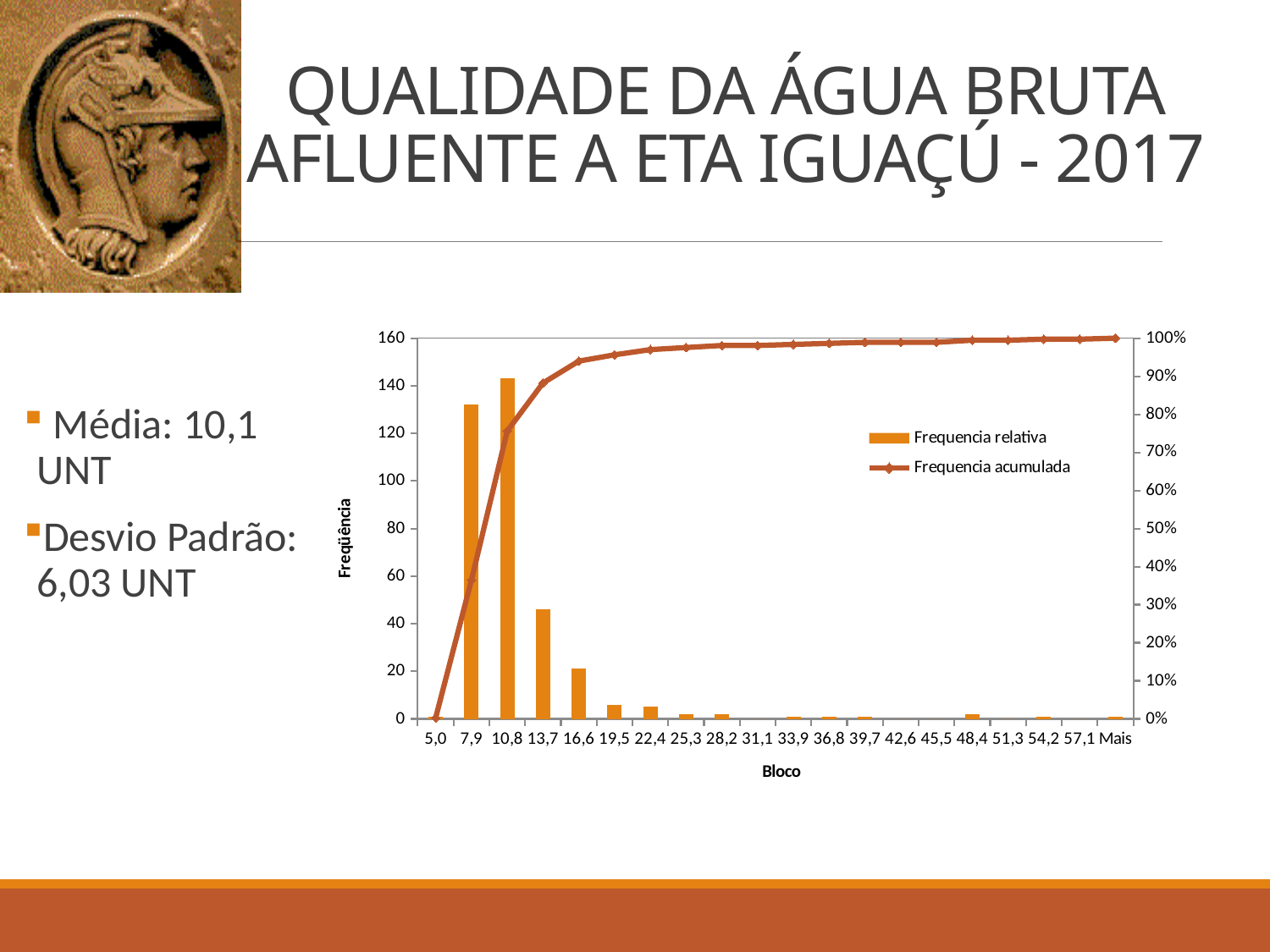
Which is larger, the Frequencia relativa bar for bloco 7,9 or for bloco 13,7? 7,9 What are the two series named in the chart legend? Frequencia relativa and Frequencia acumulada How many series does the chart legend list? 2 Which bloco has the highest Frequencia relativa bar? 10,8 Is the Frequencia acumulada value at bloco 7,9 greater or less than 50%? less Is the Frequencia relativa bar for bloco 7,9 greater or less than 120? greater Is the Frequencia acumulada value at bloco 16,6 greater or less than 90%? greater Does the Frequencia acumulada line rise or fall along the x axis? rise How many bloco categories are shown on the x axis? 20 What is the title of the chart's x axis? Bloco